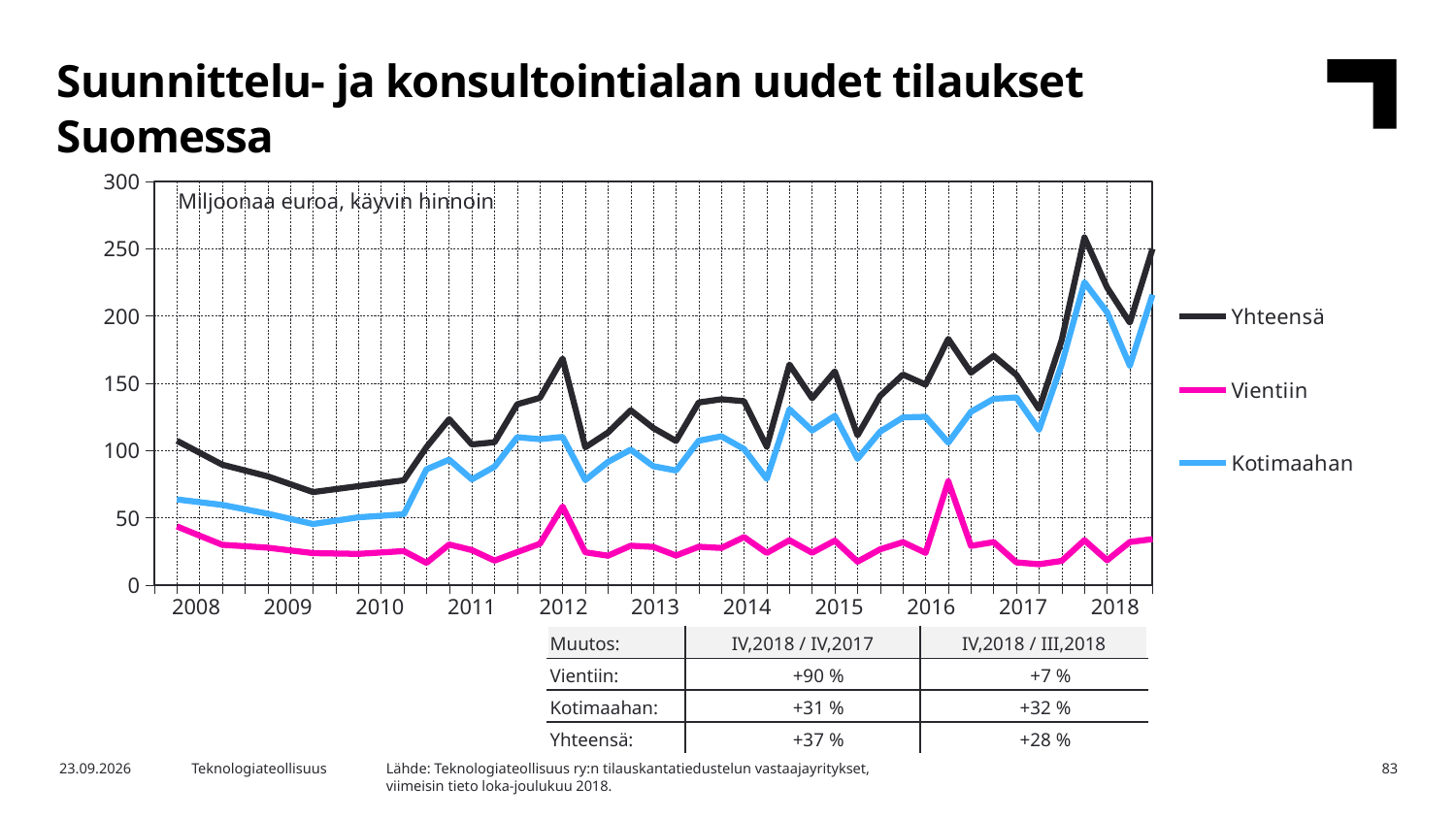
Is the peak value of Vientiin in 2016 greater or less than 50? greater Which series is larger in 2018, Kotimaahan or Vientiin? Kotimaahan Is the lowest value of Yhteensä in 2009 greater or less than 100? less How many year labels are shown on the x axis? 11 What unit is stated in the label inside the chart area? Miljoonaa euroa, käyvin hinnoin What are the series names listed in the legend? Yhteensä, Vientiin, Kotimaahan Does the Yhteensä series rise or fall from 2008 to 2009? fall What kind of chart is shown on the slide? line chart How many series does the legend list? 3 Which series reaches the highest value on the chart? Yhteensä Which series has the lowest values throughout the chart? Vientiin Is the peak value of Yhteensä in 2017 greater or less than 200? less